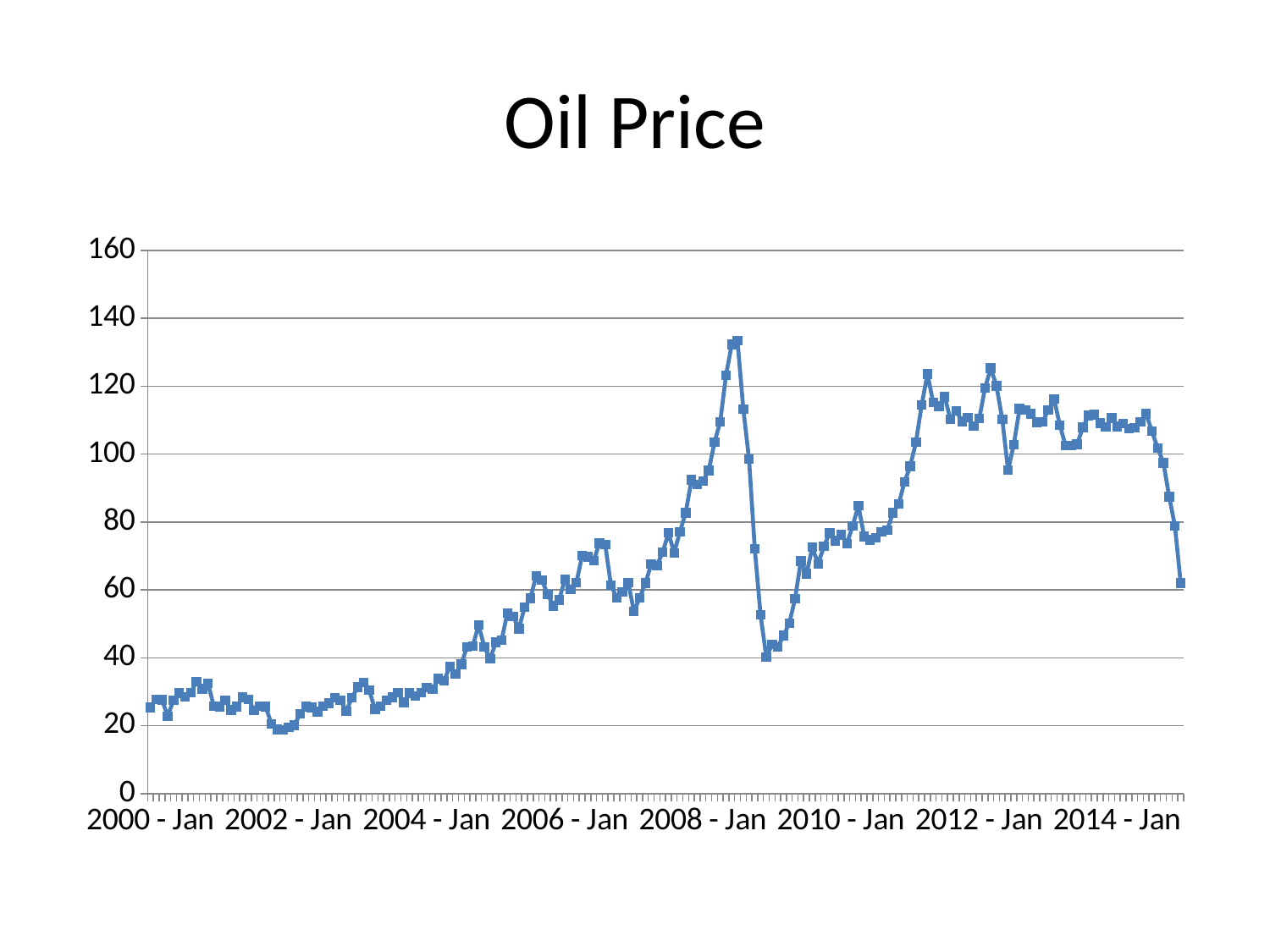
Which is larger, the value for 2000 - Jan or the value for 2014 - Jan? 2014 - Jan Is the value for 2008 - Jan greater or less than 80? greater Is the highest value on the chart greater or less than 120? greater Is the value for 2004 - Jan greater or less than 40? less What is the title of the chart? Oil Price Does the oil price rise or fall between 2002 - Jan and 2008 - Jan? rise How many lines are plotted on the chart? 1 What kind of chart is shown on the slide? line chart